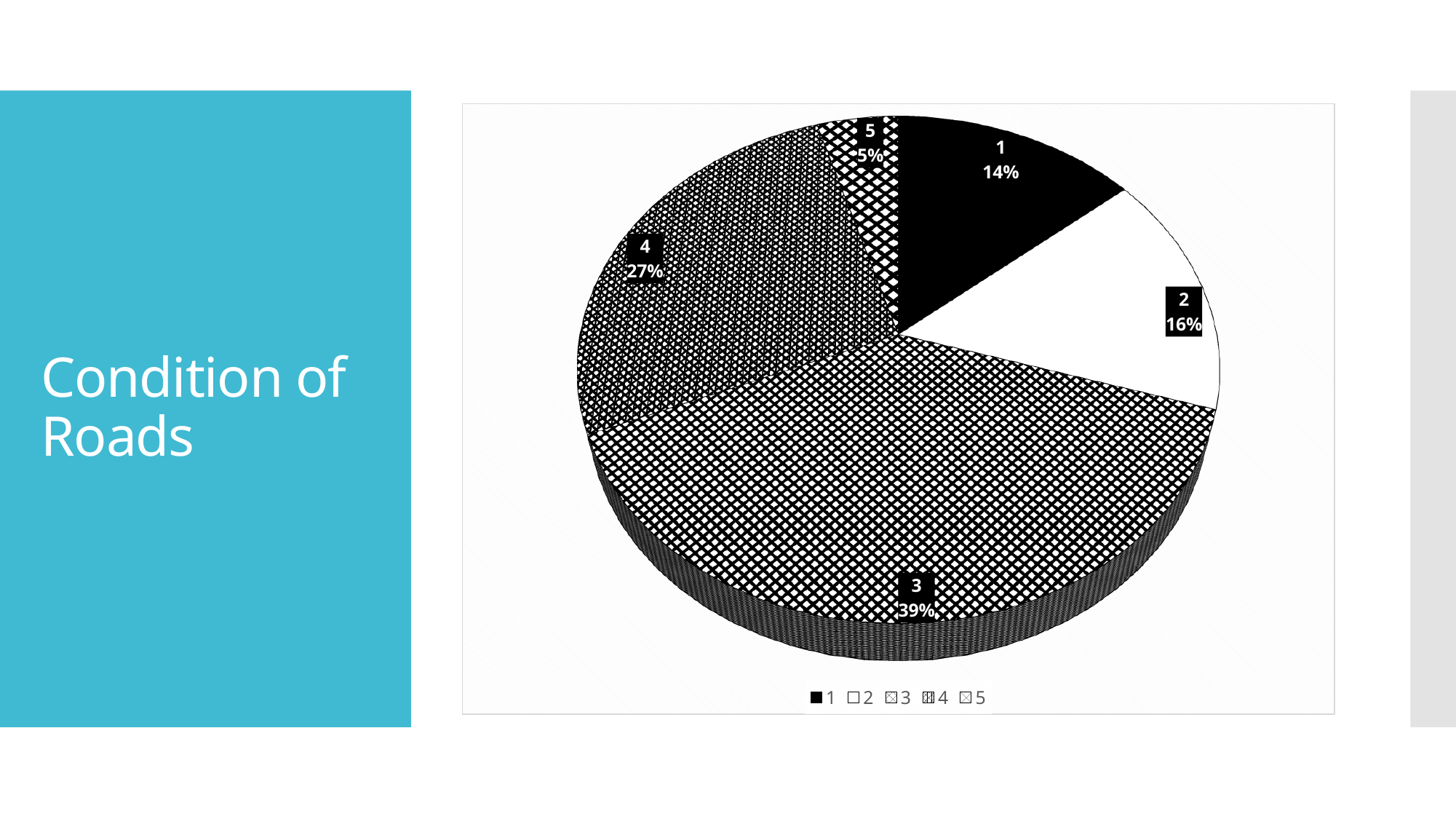
What percentage share does category 1 have in the pie chart? 14% What kind of chart is shown on the slide? pie chart Which is larger, the share for category 2 or the share for category 1? 2 What percentage share does category 5 have in the pie chart? 5% Which category has the largest slice of the pie chart? 3 What is the difference in percentage points between category 3 and category 4? 12 Which category has the smallest slice of the pie chart? 5 What percentage share does category 3 have in the pie chart? 39% How many entries does the legend list? 5 What percentage share does category 4 have in the pie chart? 27% How many categories are shown in the pie chart? 5 What is the title text shown on the slide next to the chart? Condition of Roads